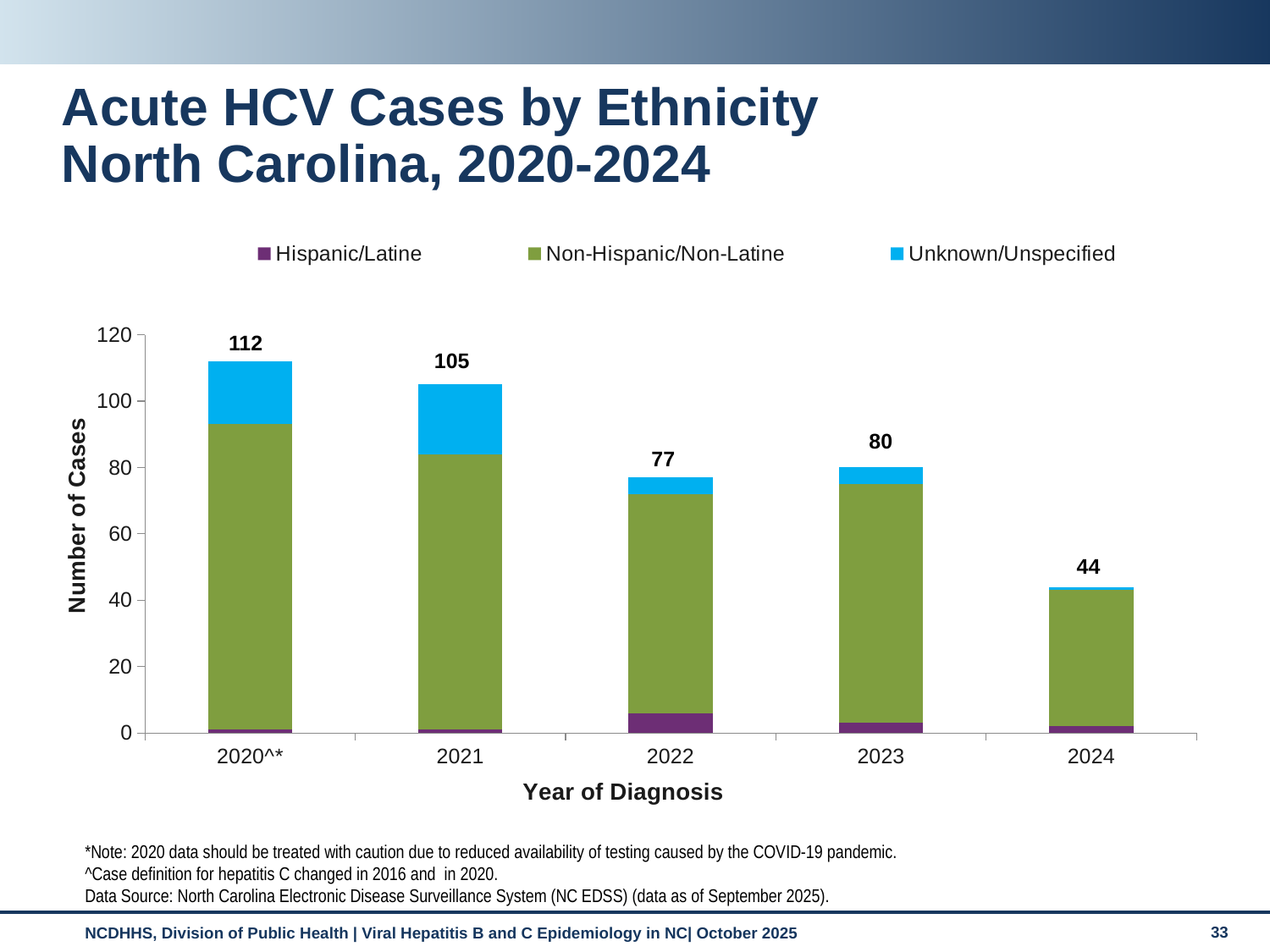
Is the Non-Hispanic/Non-Latine value for 2020^* greater or less than 80? greater Which series is shown in blue in the legend? Unknown/Unspecified What is the difference between the total cases in 2020^* and 2024? 68 What is the difference between the total cases in 2023 and 2022? 3 Which year has more total cases, 2021 or 2023? 2021 Which year has the lowest total number of acute HCV cases? 2024 What kind of chart is shown on the slide? Stacked bar chart How many years are shown on the x axis? 5 Which year has the highest total number of acute HCV cases? 2020^* What is the total number of acute HCV cases shown for 2024? 44 How many series does the legend list? 3 What is the total number of acute HCV cases shown for 2021? 105